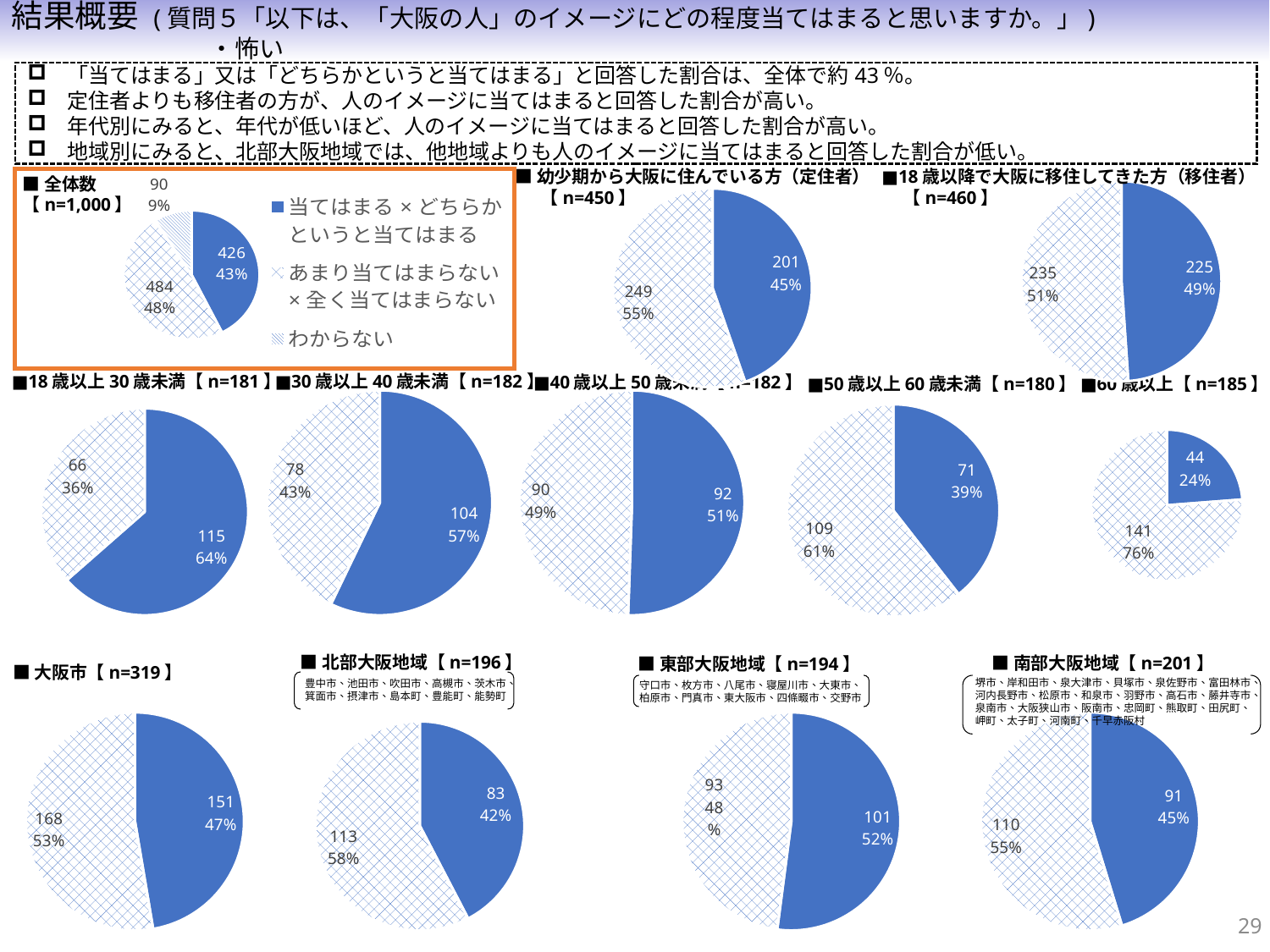
In the 18歳以上30歳未満 (n=181) pie chart, what percentage is shown for the blue (当てはまる) slice? 64% In the 18歳以降で大阪に移住してきた方 (n=460) pie chart, what is the difference between the two slice counts (235 and 225)? 10 Which pie chart shows a larger blue (当てはまる) share: 幼少期から大阪に住んでいる方 (定住者) or 18歳以降で大阪に移住してきた方 (移住者)? 18歳以降で大阪に移住してきた方 (移住者) In the 東部大阪地域 (n=194) pie chart, what is the count shown for the blue (当てはまる) slice? 101 In the 全体数 (n=1,000) pie chart, what percentage is shown for the わからない slice? 9% In the 60歳以上 (n=185) pie chart, what is the count shown for the blue (当てはまる) slice? 44 Across the five age-group pie charts (18歳以上30歳未満 to 60歳以上), which age group has the lowest blue (当てはまる) percentage? 60歳以上 In the 北部大阪地域 (n=196) pie chart, what percentage is shown for the blue (当てはまる) slice? 42% In the 全体数 (n=1,000) pie chart, which slice is the largest? あまり当てはまらない × 全く当てはまらない What kind of chart is used for the 18歳以上30歳未満 (n=181) data? pie chart In the 全体数 (n=1,000) pie chart, what is the value shown for the 当てはまる × どちらかというと当てはまる slice? 426 How many entries does the legend next to the 全体数 pie chart list? 3